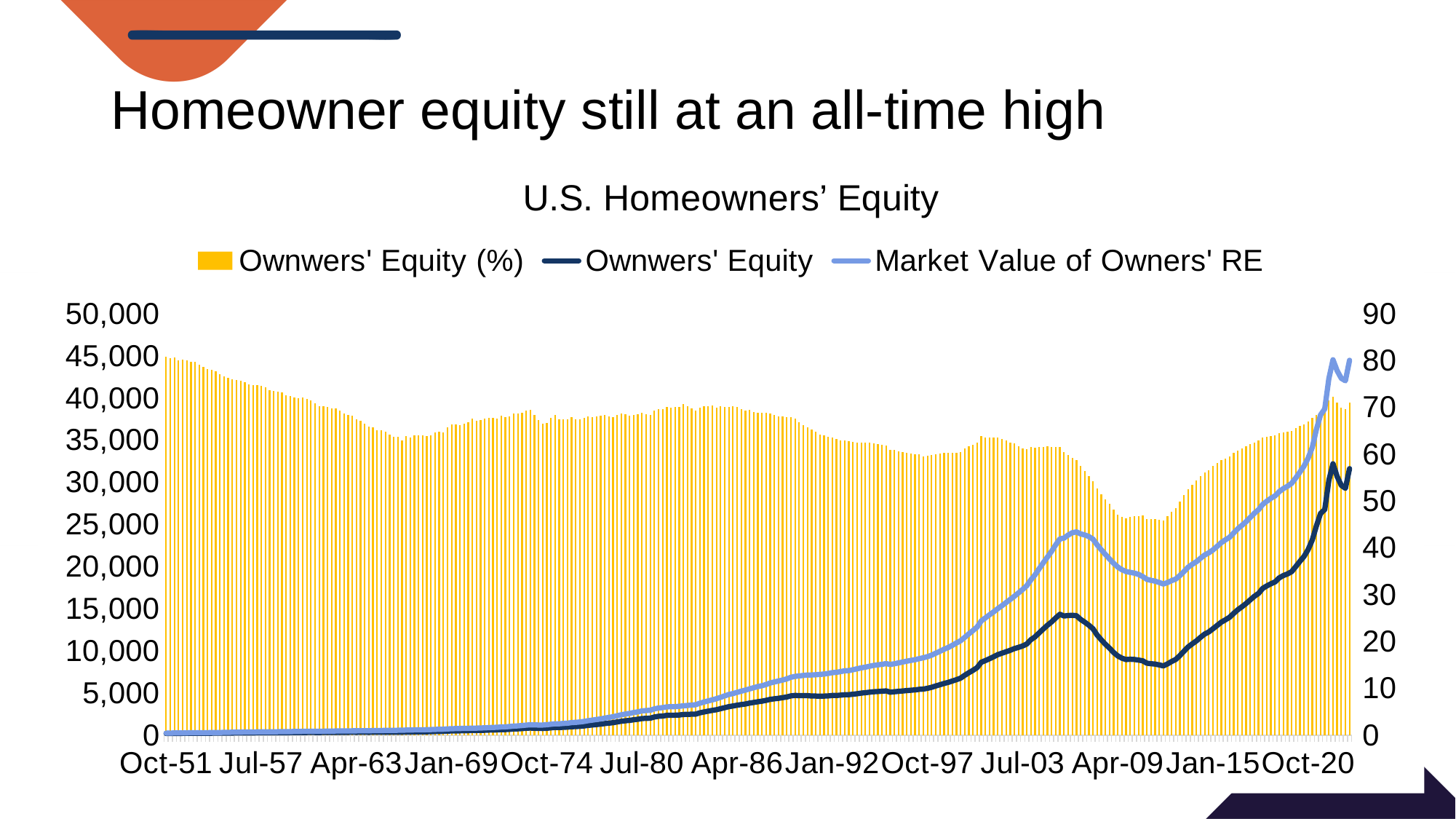
Is the Owners' Equity line at Jan-92 greater or less than 10,000 on the left axis? less Is the peak of the Market Value of Owners' RE line greater or less than 40,000 on the left axis? greater What is the highest value shown on the left vertical axis? 50,000 How many series does the chart legend list? 3 At Oct-20, which line is higher: Market Value of Owners' RE or Owners' Equity? Market Value of Owners' RE How many date labels are shown on the x axis? 13 Which series is drawn as bars rather than a line? Ownwers' Equity (%) Does the Market Value of Owners' RE line generally rise or fall from Oct-51 to Oct-20? rise What is the title of the chart? U.S. Homeowners' Equity What is the highest value shown on the right vertical axis? 90 Is the peak of the Owners' Equity line greater or less than 25,000 on the left axis? greater What kind of chart is this? Combination bar and line chart